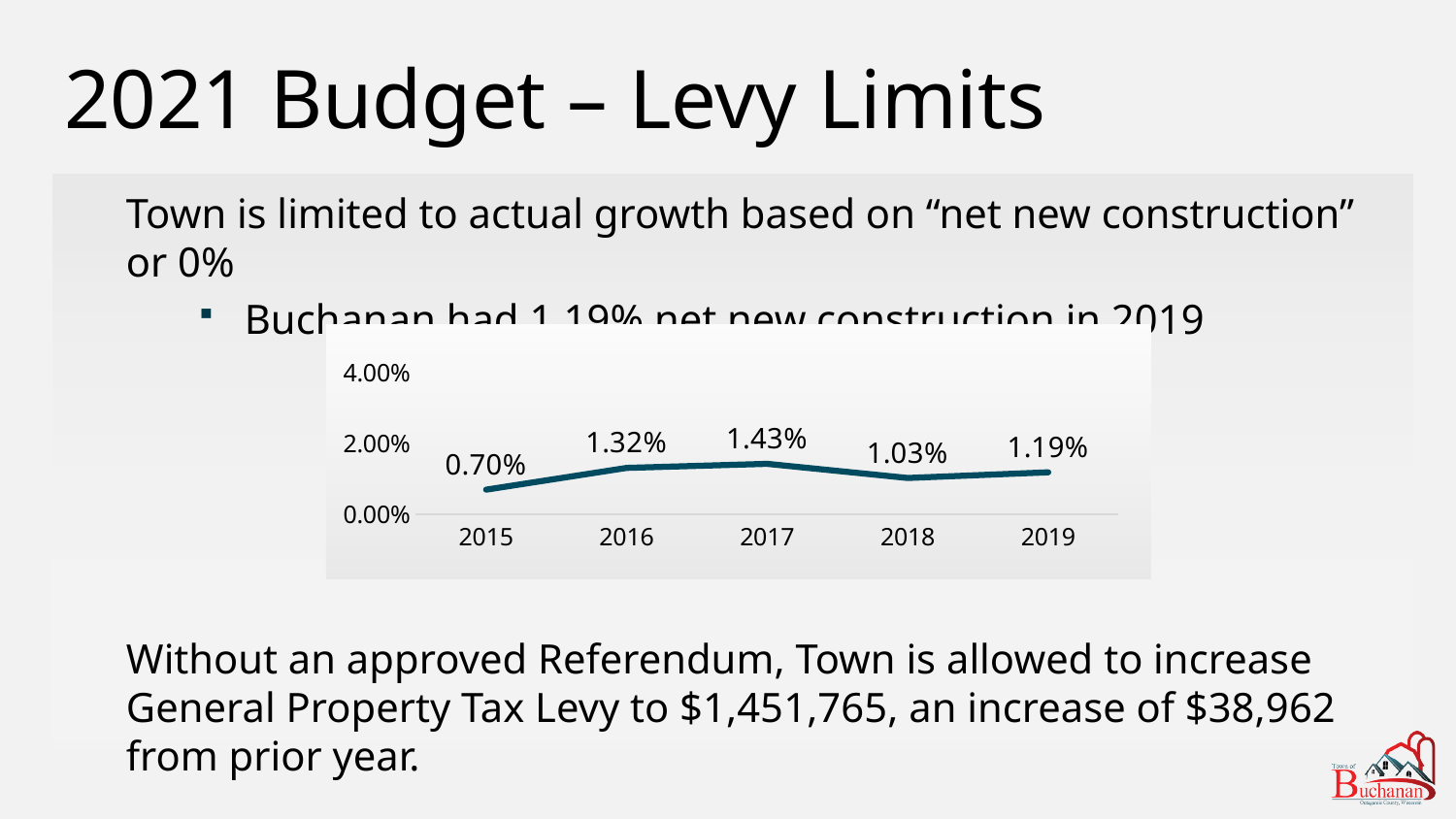
What kind of chart is shown on the slide? line chart What is the net new construction value for 2017? 1.43% What is the value plotted for 2018? 1.03% Which year has the lowest value on the chart? 2015 Does the value rise or fall from 2017 to 2018? fall What is the difference between the 2017 value and the 2015 value? 0.73% Which year has the highest value on the chart? 2017 What is the highest tick label shown on the vertical axis? 4.00% How many years are plotted on the chart? 5 Which is larger, the value for 2016 or the value for 2018? 2016 Is the value for 2019 greater or less than 2.00%? less What is the value plotted for 2015? 0.70%